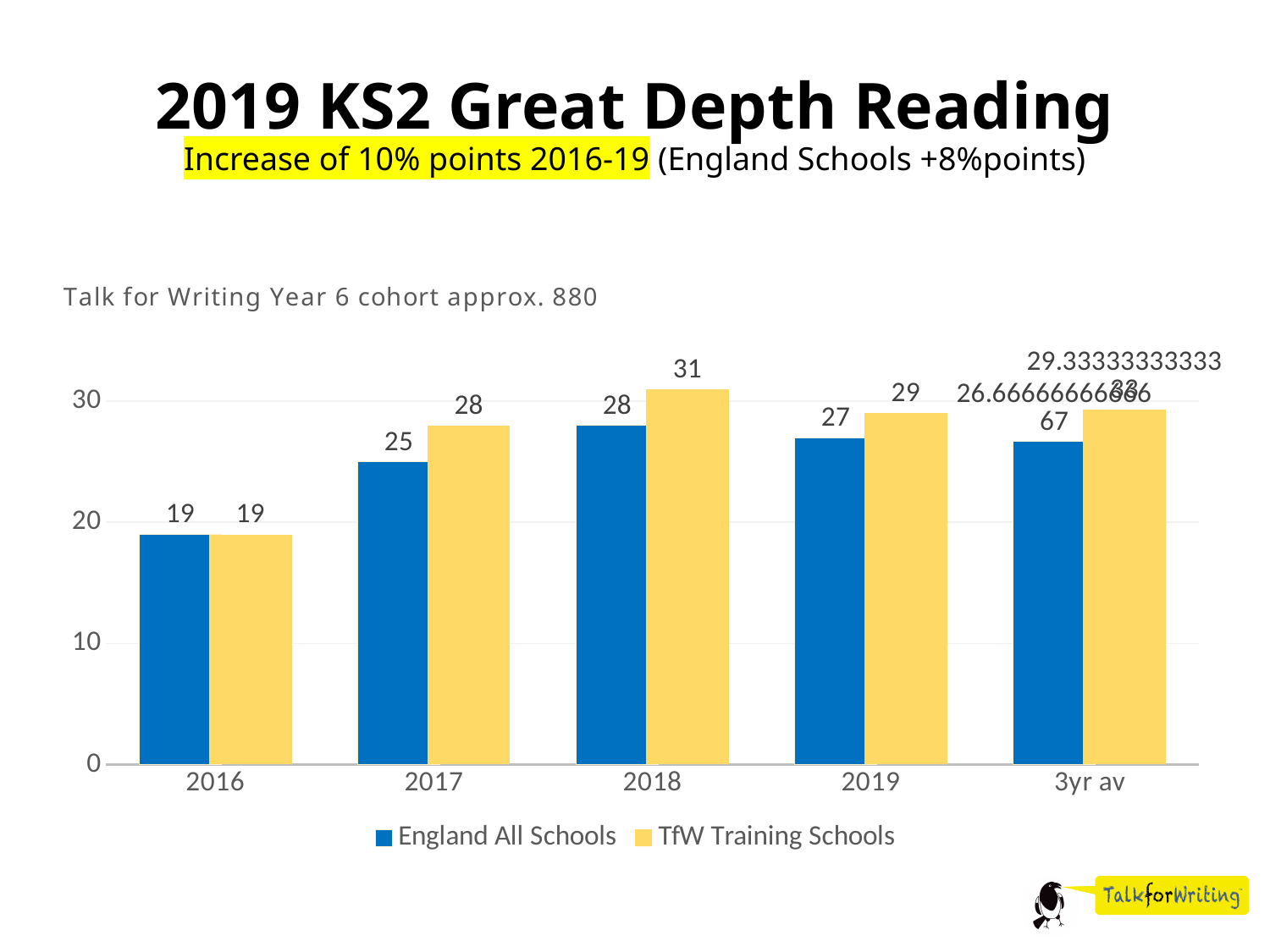
How many series does the legend list? 2 What is the value for TfW Training Schools in 2018? 31 What is the value for England All Schools in 2017? 25 In which year is the England All Schools value lowest? 2016 How many categories are shown on the x axis? 5 In which year is the TfW Training Schools value highest? 2018 What is the difference between TfW Training Schools and England All Schools in 2017? 3 Is the value for England All Schools in 2018 greater or less than 20? greater Which is larger in 2019, England All Schools or TfW Training Schools? TfW Training Schools What is the value for England All Schools in 2016? 19 What kind of chart is shown on the slide? bar chart What is the value for TfW Training Schools in 2019? 29